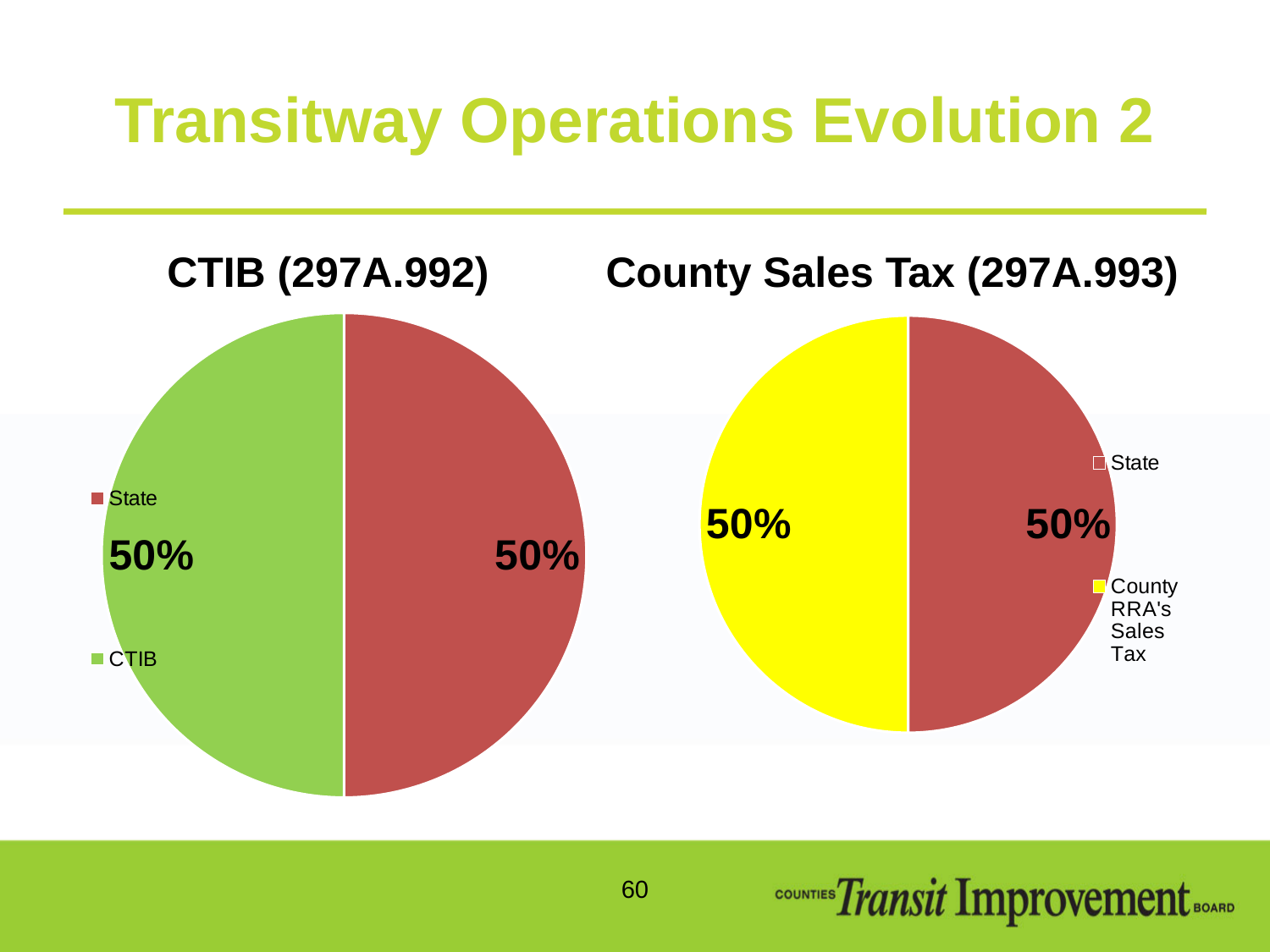
In the County Sales Tax (297A.993) chart, what share of the pie is County RRA's Sales Tax? 50% What kind of chart is the County Sales Tax (297A.993) chart? pie chart In the County Sales Tax (297A.993) chart, what share of the pie is State? 50% What is the title of the chart on the left side of the slide? CTIB (297A.992) How many entries does the legend of the County Sales Tax (297A.993) chart list? 2 In the CTIB (297A.992) chart, what is the difference between the State share and the CTIB share? 0% In the CTIB (297A.992) chart, what share of the pie is CTIB? 50% How many slices does the County Sales Tax (297A.993) pie chart have? 2 In the County Sales Tax (297A.993) chart, what colour is the County RRA's Sales Tax slice? yellow How many slices does the CTIB (297A.992) pie chart have? 2 What kind of chart is the CTIB (297A.992) chart? pie chart